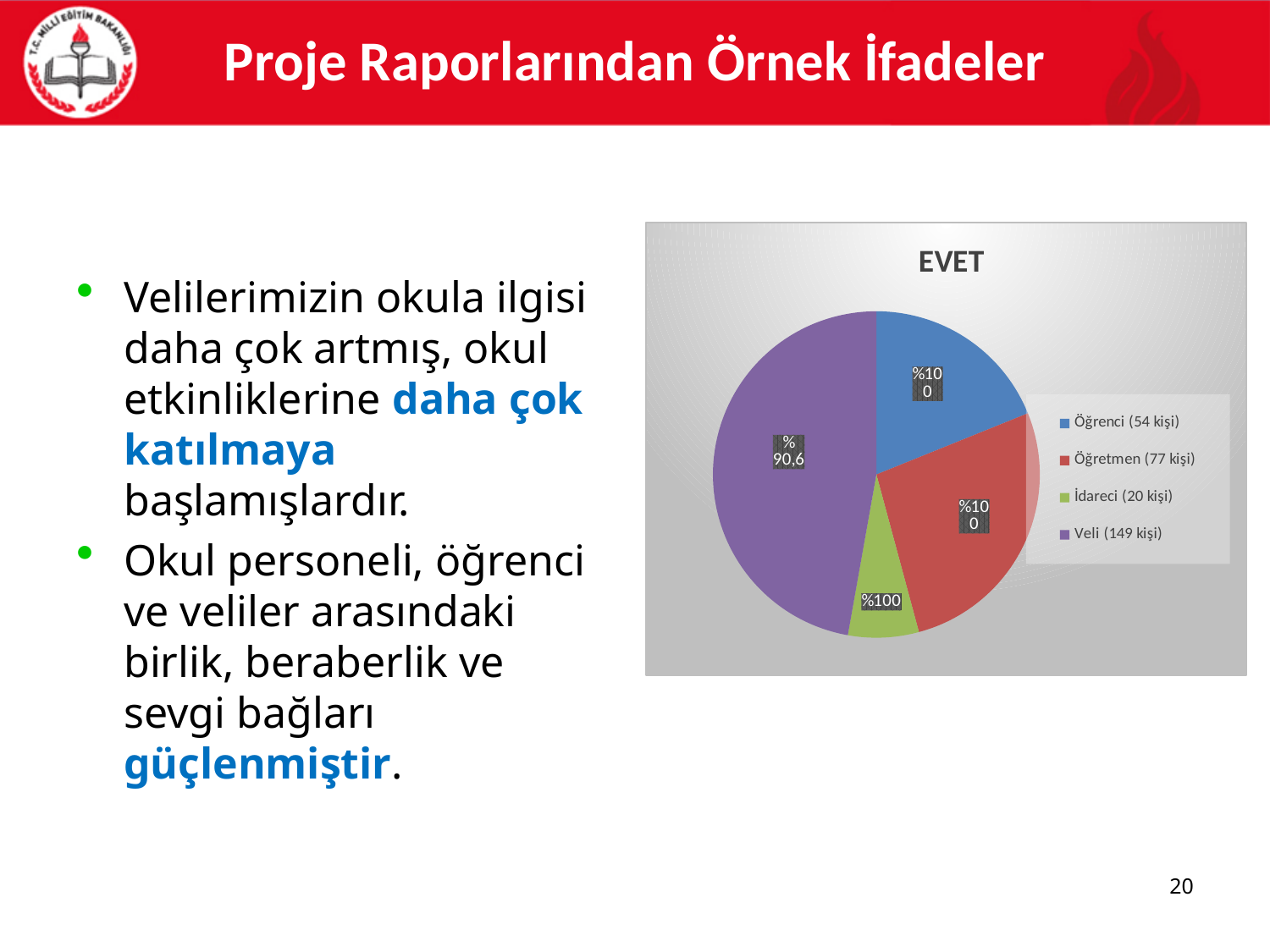
What is the data label shown on the İdareci slice of the pie chart? %100 What colour is the Veli slice in the pie chart? purple How many slices does the pie chart have? 4 What is the title of the pie chart? EVET What is the data label shown on the Öğrenci slice of the pie chart? %100 What is the data label shown on the Veli slice of the pie chart? %90,6 Which category occupies the smallest slice of the pie chart? İdareci (20 kişi) Which slice is larger in the pie chart, Öğretmen or Öğrenci? Öğretmen Which slice has the lowest percentage label in the pie chart? Veli Which category occupies the largest slice of the pie chart? Veli (149 kişi) What kind of chart is shown on the slide? pie chart According to the legend, how many more people are in the Veli group than in the Öğrenci group? 95